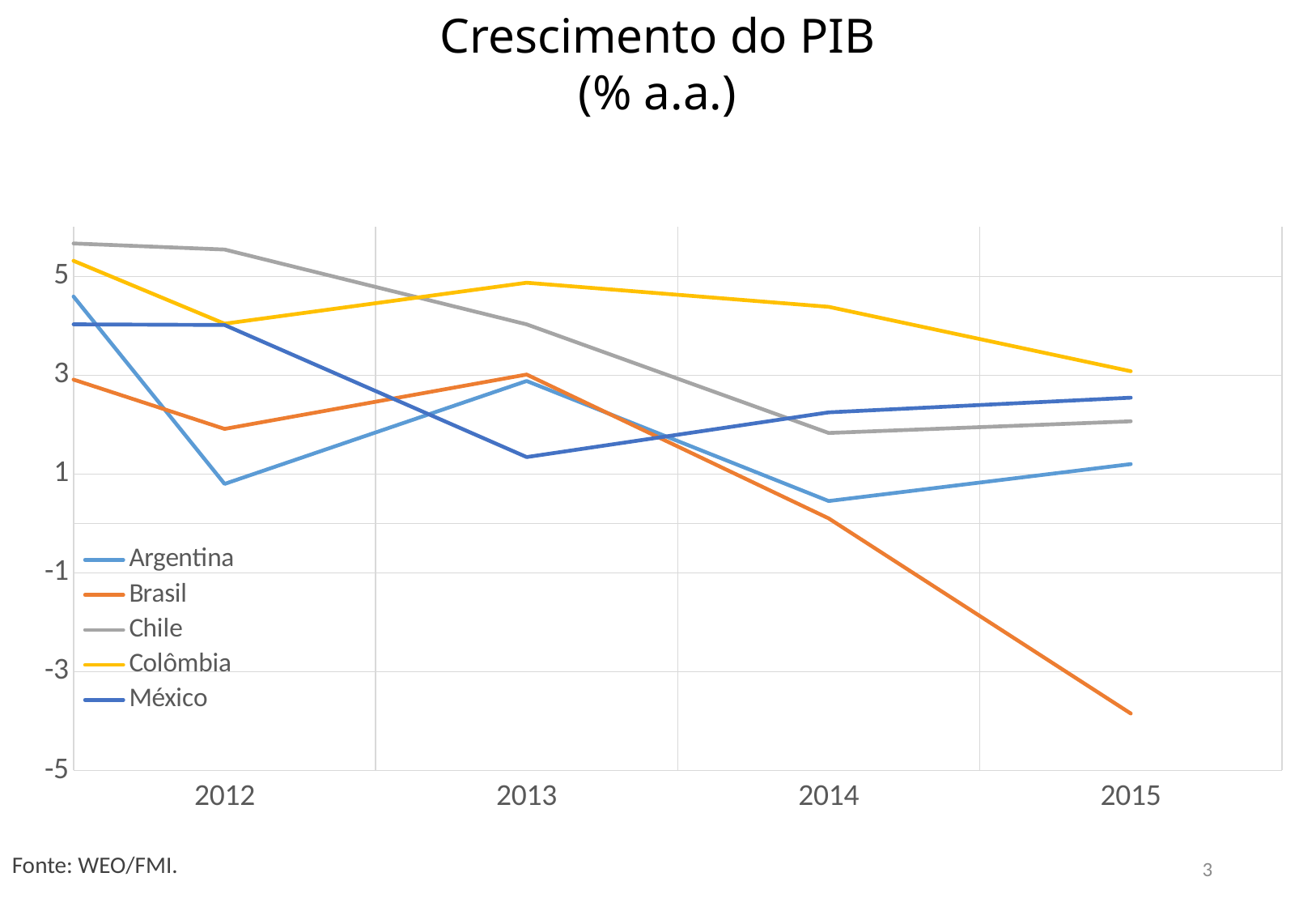
How many years are labeled on the x axis? 4 Which country has the highest GDP growth in 2015? Colômbia In 2014, which is larger: the value for Colômbia or the value for Argentina? Colômbia Which country has the lowest GDP growth in 2015? Brasil Does the line for Brasil rise or fall from 2013 to 2015? fall Which country has the highest GDP growth in 2012? Chile What is the title of the chart? Crescimento do PIB (% a.a.) Is the value for Chile in 2014 greater or less than 3? less Is the value for Colômbia in 2013 greater or less than 3? greater How many series does the legend list? 5 What kind of chart is shown on the slide? line chart Is the value for Brasil in 2015 greater or less than -3? less